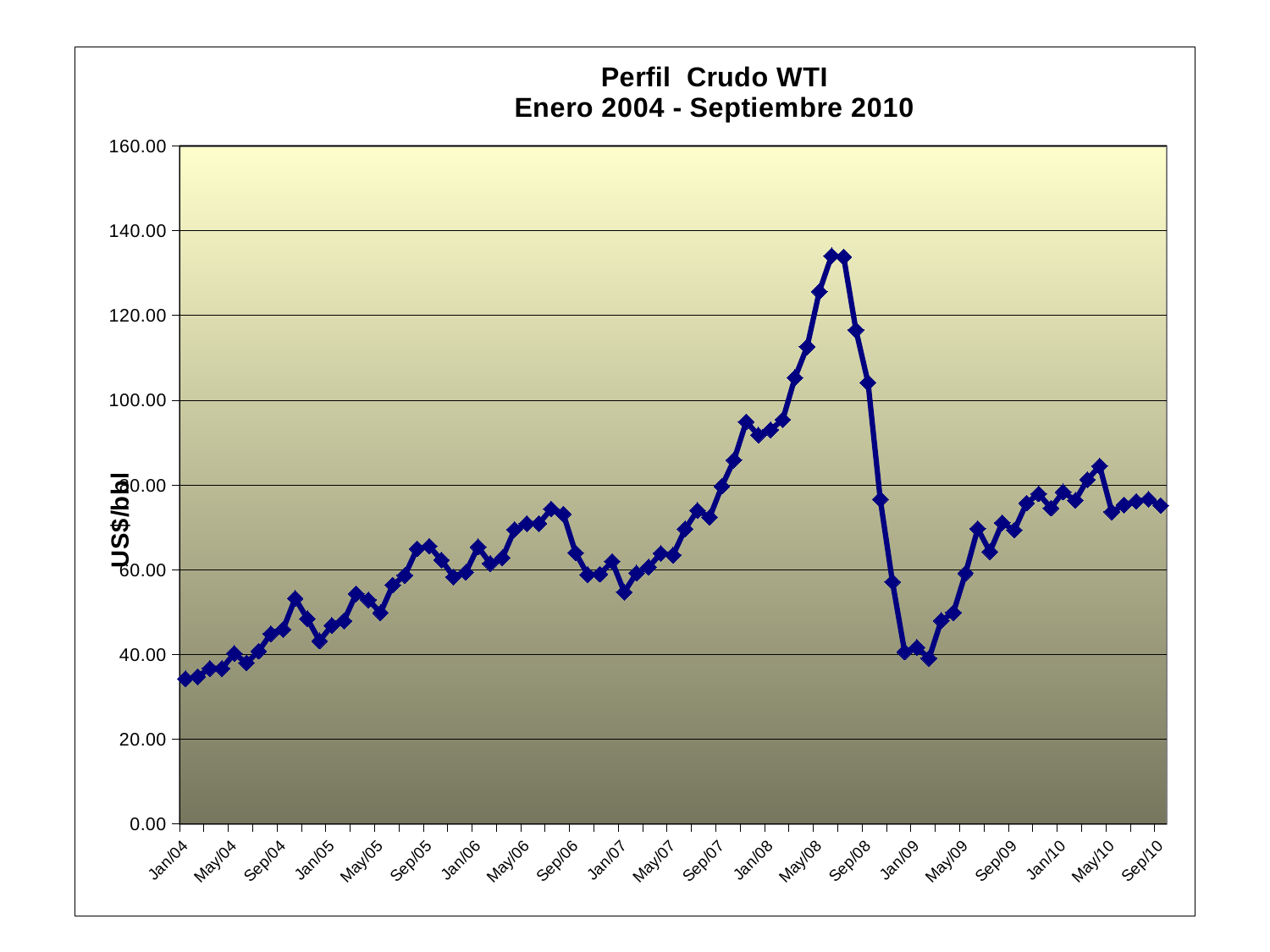
Is the value for May/08 greater or less than 100? greater Between May/08 and Jan/09, does the line rise or fall? fall Is the value for Sep/06 greater or less than 80? less What kind of chart is shown on the slide? line chart What is the label on the vertical axis of the chart? US$/bbl What is the title of the chart? Perfil Crudo WTI Enero 2004 - Septiembre 2010 Is the value for Jan/04 greater or less than 40? less In which year does the line reach its highest value? 2008 Which is larger, the value for Jan/04 or the value for Jan/08? Jan/08